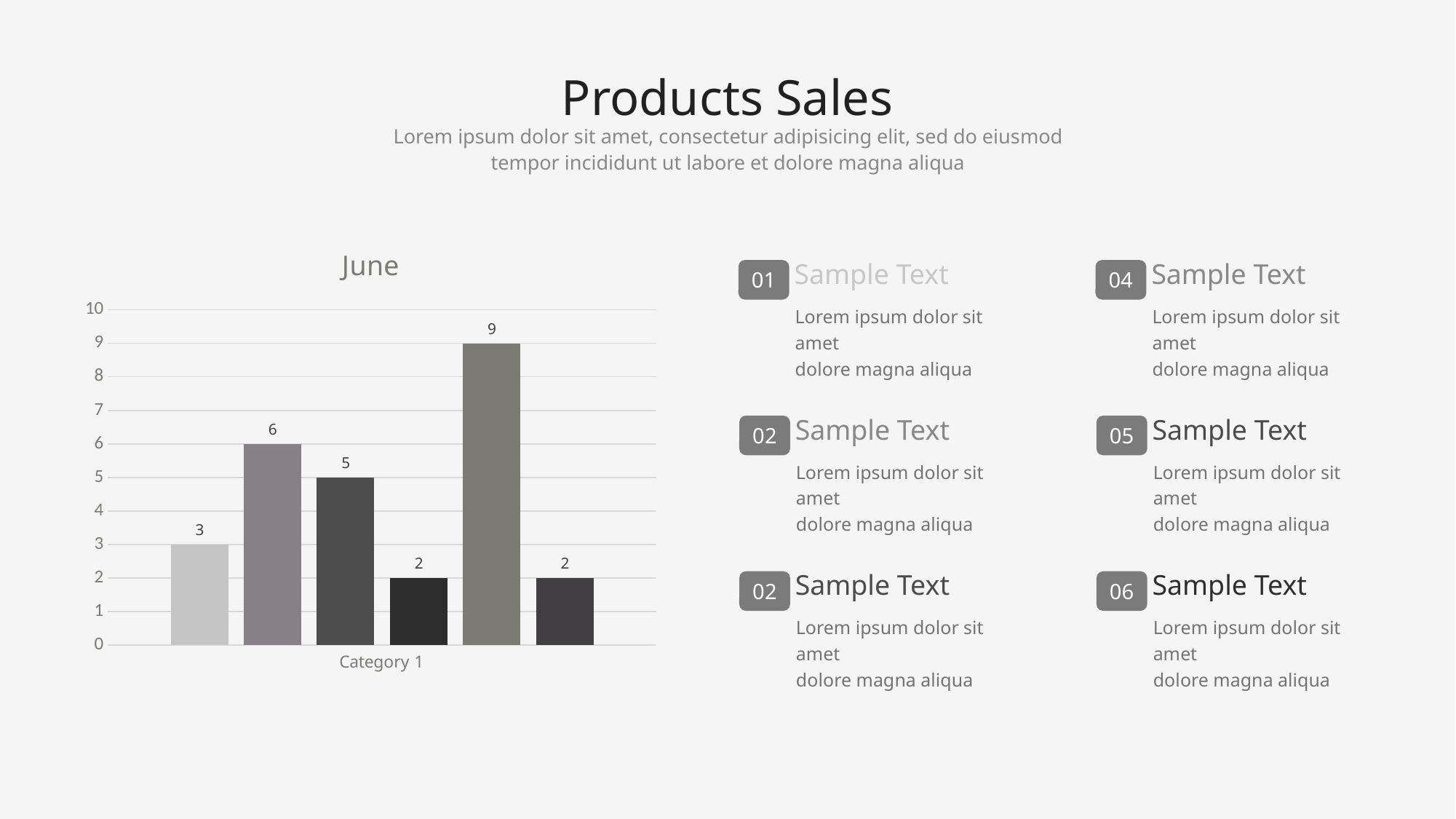
What is the highest value shown by any bar in the chart? 9 What is the value of the second bar from the left in the chart? 6 What is the difference between the tallest bar and the second bar from the left? 3 Is the value of the fifth bar from the left greater or less than 8? greater What is the category label shown on the x axis of the chart? Category 1 Which is larger, the value of the first bar or the value of the third bar? the third bar What is the title of the chart? June What is the value of the third bar from the left in the chart? 5 What kind of chart is shown on the slide? bar chart What is the value of the first (leftmost) bar in the chart? 3 What is the lowest value shown by any bar in the chart? 2 How many bars are plotted in the chart? 6